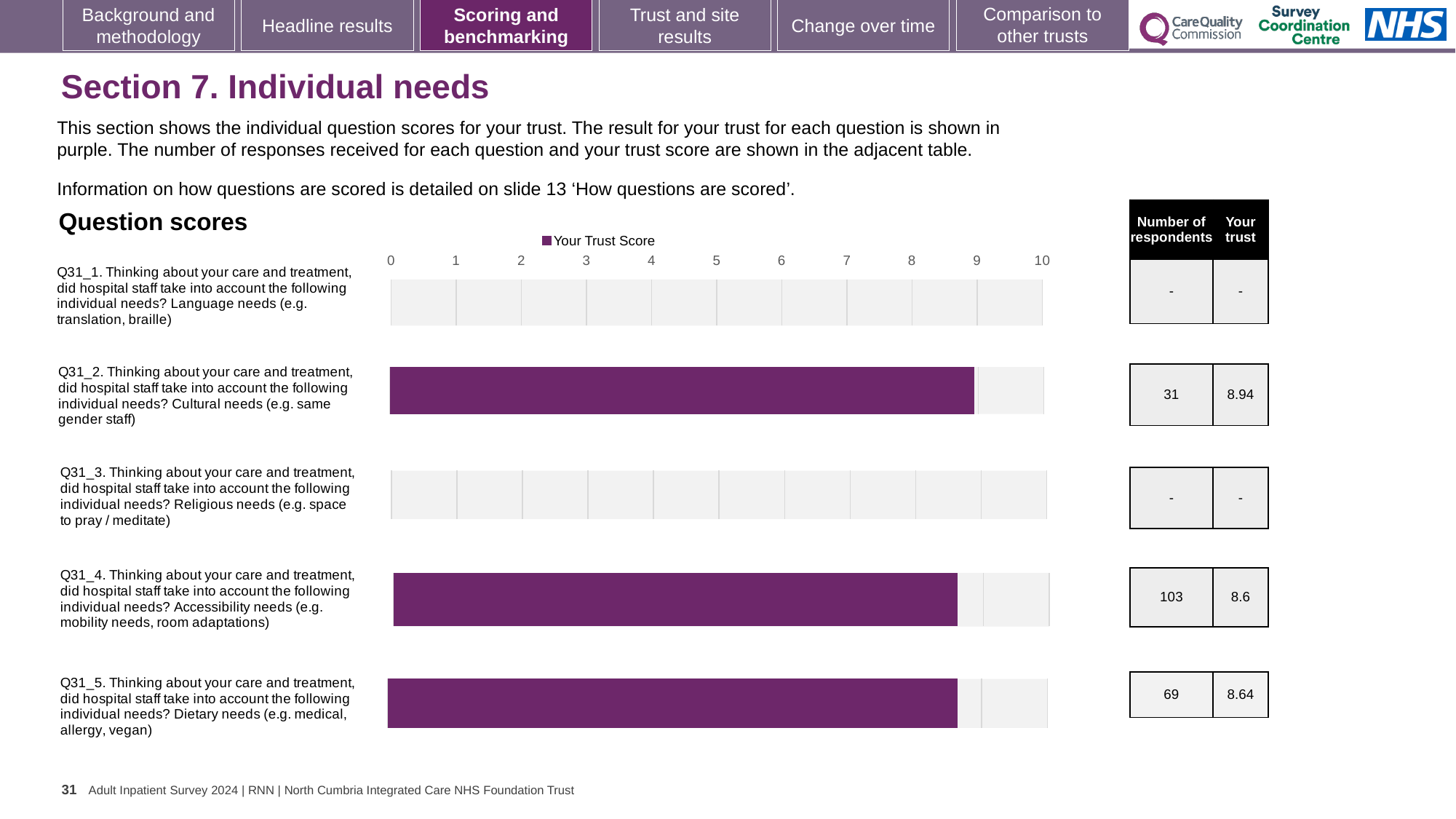
Is the trust score for Q31_2 (Cultural needs) greater or less than 8? greater What is the trust score for Q31_2 (Cultural needs)? 8.94 How many respondents answered Q31_4 (Accessibility needs)? 103 What is the difference between the trust scores for Q31_2 and Q31_4? 0.34 How many questions are listed in the Question scores chart? 5 Which question with a score shown has the lowest trust score? Q31_4 (Accessibility needs) Which question has the highest trust score shown? Q31_2 (Cultural needs) What type of chart is used to show the question scores? Bar chart What is the trust score for Q31_4 (Accessibility needs)? 8.6 What is the trust score for Q31_5 (Dietary needs)? 8.64 Which has a higher trust score, Q31_5 (Dietary needs) or Q31_4 (Accessibility needs)? Q31_5 (Dietary needs) How many respondents answered Q31_2 (Cultural needs)? 31